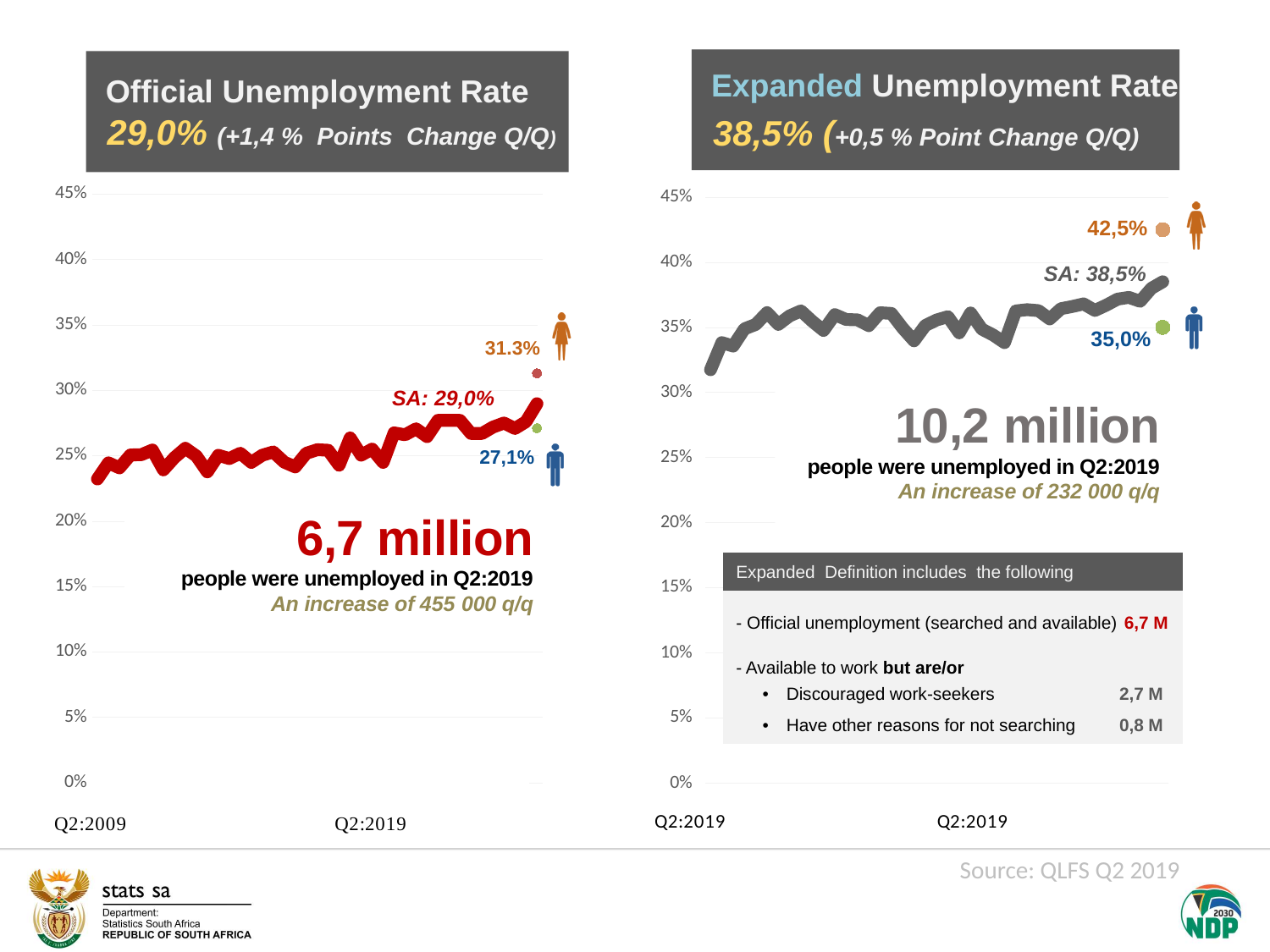
On the Expanded Unemployment Rate chart, what is the value labelled next to the female figure? 42,5% On the Expanded Unemployment Rate chart, which is larger, the female rate or the male rate? Female rate (42,5%) On the Official Unemployment Rate chart, does the line generally rise or fall from Q2:2009 to Q2:2019? Rise On the Expanded Unemployment Rate chart, what is the difference between the female rate (42,5%) and the male rate (35,0%)? 7,5 percentage points What kind of chart is the Official Unemployment Rate chart? Line chart On the Expanded Unemployment Rate chart, what is the SA expanded unemployment rate shown at the end of the line? SA: 38,5% On the Official Unemployment Rate chart, is the value at the start of the line (Q2:2009) greater or less than 25%? less On the Official Unemployment Rate chart, what is the SA unemployment rate shown at the end of the line? 29,0% On the Official Unemployment Rate chart, what is the value labelled next to the male figure? 27,1% On the Expanded Unemployment Rate chart, what is the value labelled next to the male figure? 35,0% On the Official Unemployment Rate chart, what is the difference between the female rate (31.3%) and the male rate (27,1%)? 4,2 percentage points On the Official Unemployment Rate chart, what is the value labelled next to the female figure? 31.3%